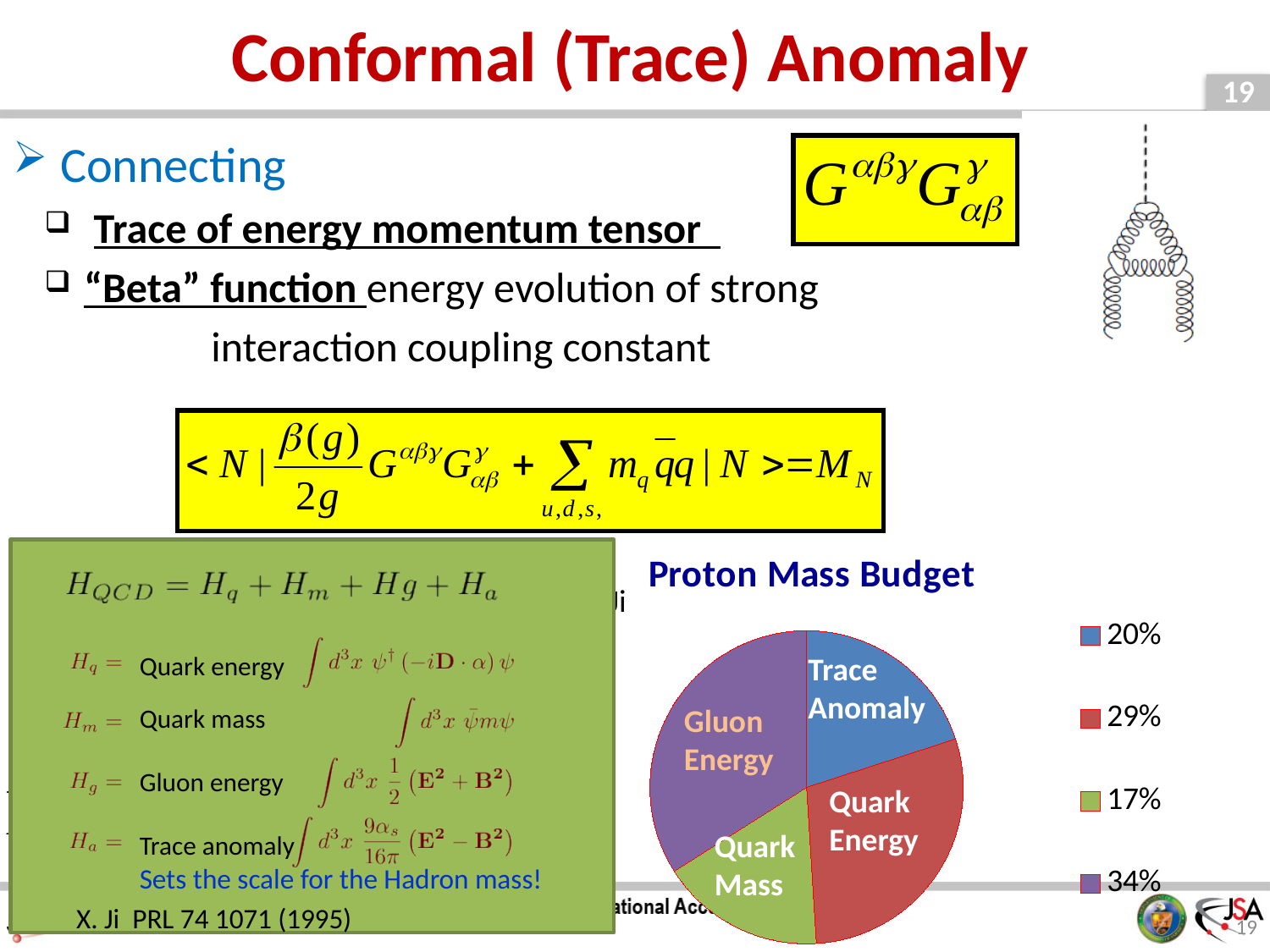
In the Proton Mass Budget pie chart, what share is shown for the Quark Energy slice? 29% In the Proton Mass Budget pie chart, what share is shown for the Quark Mass slice? 17% What kind of chart is the Proton Mass Budget chart? pie chart Which slice of the Proton Mass Budget pie chart is the smallest? Quark Mass In the Proton Mass Budget pie chart, which is larger, Quark Energy or Trace Anomaly? Quark Energy What colour is the Gluon Energy slice in the Proton Mass Budget pie chart? purple In the Proton Mass Budget pie chart, what is the difference between the Gluon Energy share and the Quark Mass share? 17% How many slices does the Proton Mass Budget pie chart have? 4 In the Proton Mass Budget pie chart, what share is shown for the Gluon Energy slice? 34% Which slice of the Proton Mass Budget pie chart is the largest? Gluon Energy In the Proton Mass Budget pie chart, what is the combined share of Quark Energy and Quark Mass? 46%